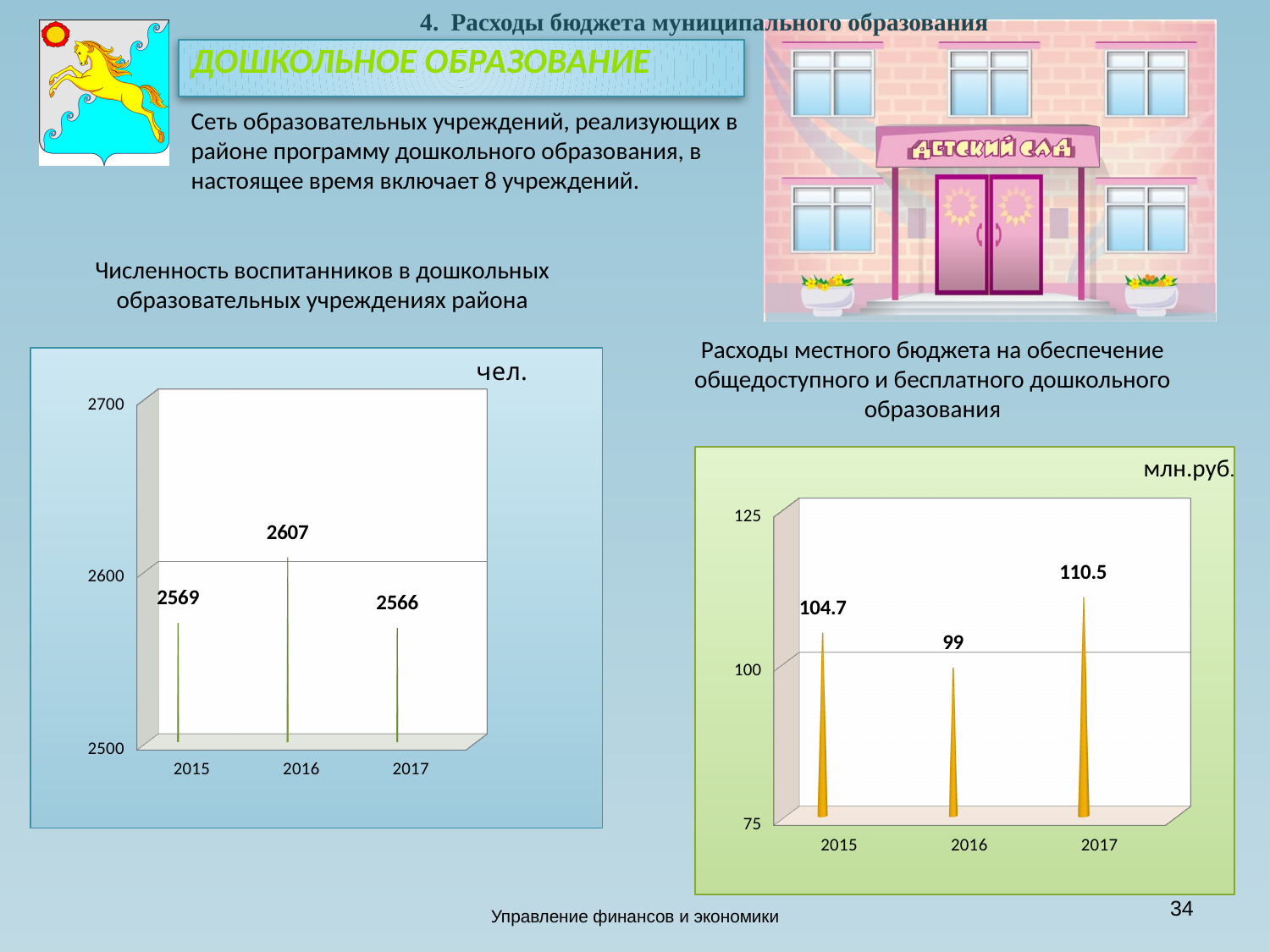
On the right chart (Расходы местного бюджета), is the value for 2015 greater or less than 100? greater On the left chart (Численность воспитанников), how many years are shown on the x axis? 3 On the left chart (Численность воспитанников), what is the difference between the values for 2016 and 2015? 38 On the left chart (Численность воспитанников), what is the value for 2016? 2607 On the right chart (Расходы местного бюджета), what is the value for 2015? 104.7 On the right chart (Расходы местного бюджета), which year has the highest value? 2017 On the left chart (Численность воспитанников), which year has the lowest value? 2017 On the left chart (Численность воспитанников), which year has the highest value? 2016 On the right chart (Расходы местного бюджета), what is the difference between the values for 2017 and 2016? 11.5 On the right chart (Расходы местного бюджета), what unit is shown in the top right corner of the chart? млн.руб. On the left chart (Численность воспитанников), what is the value for 2017? 2566 On the right chart (Расходы местного бюджета), what is the value for 2016? 99